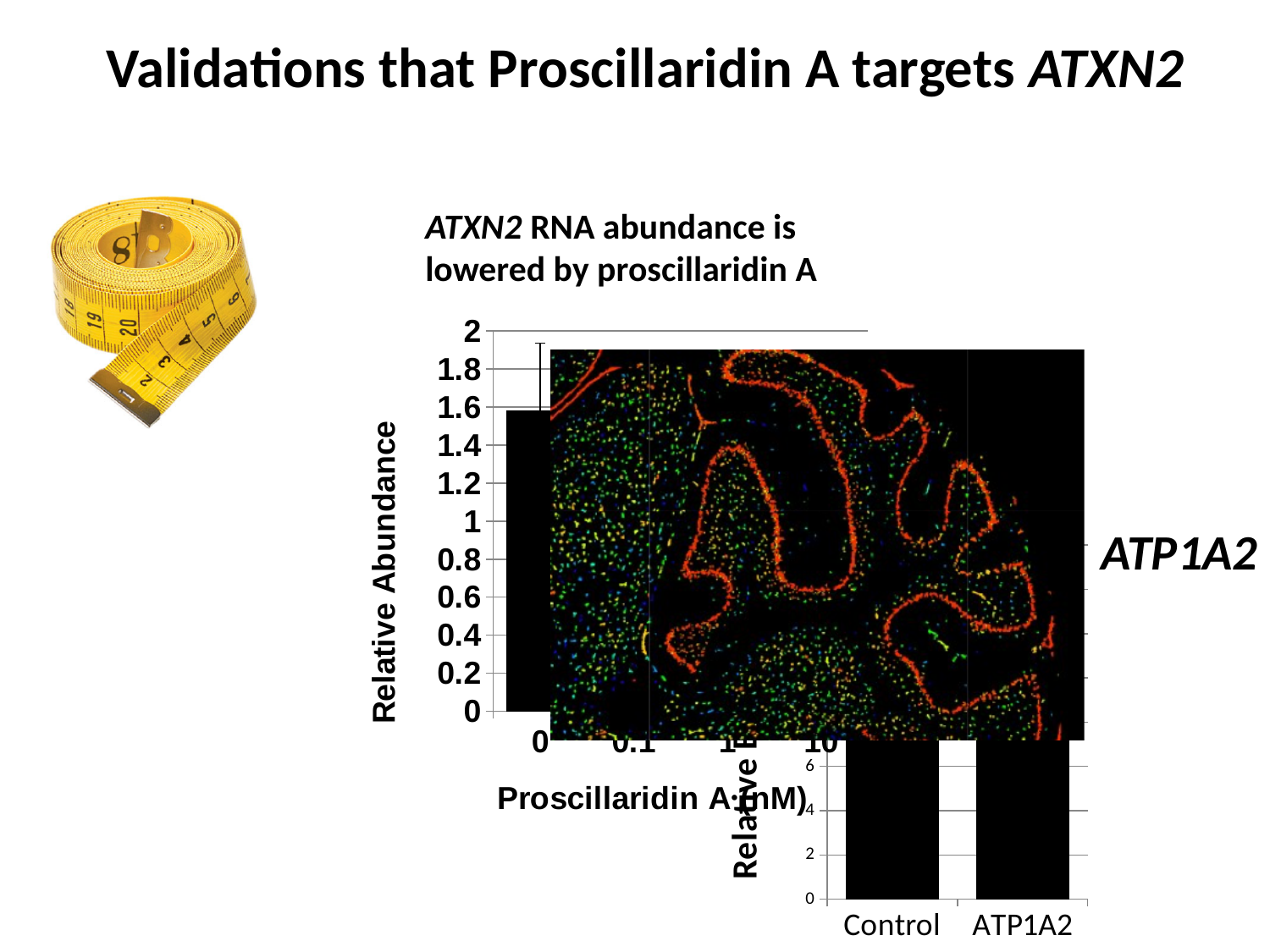
In the 'ATXN2 RNA abundance is lowered by proscillaridin A' chart, is the relative abundance at 0 nM greater or less than 2? less What is the x-axis title of the 'ATXN2 RNA abundance is lowered by proscillaridin A' chart? Proscillaridin A (nM) What kind of chart is the chart at the bottom right of the slide with the categories Control and ATP1A2? bar chart What is the y-axis title of the 'ATXN2 RNA abundance is lowered by proscillaridin A' chart? Relative Abundance In the 'ATXN2 RNA abundance is lowered by proscillaridin A' chart, how many proscillaridin A concentrations are shown on the x axis? 4 How many categories are shown on the x axis of the chart at the bottom right of the slide? 2 In the 'ATXN2 RNA abundance is lowered by proscillaridin A' chart, is the relative abundance at 0 nM greater or less than 1? greater What kind of chart is the 'ATXN2 RNA abundance is lowered by proscillaridin A' chart? bar chart In the chart at the bottom right of the slide, is the value for Control greater or less than 4? greater In the 'ATXN2 RNA abundance is lowered by proscillaridin A' chart, what is the highest tick value shown on the y axis? 2